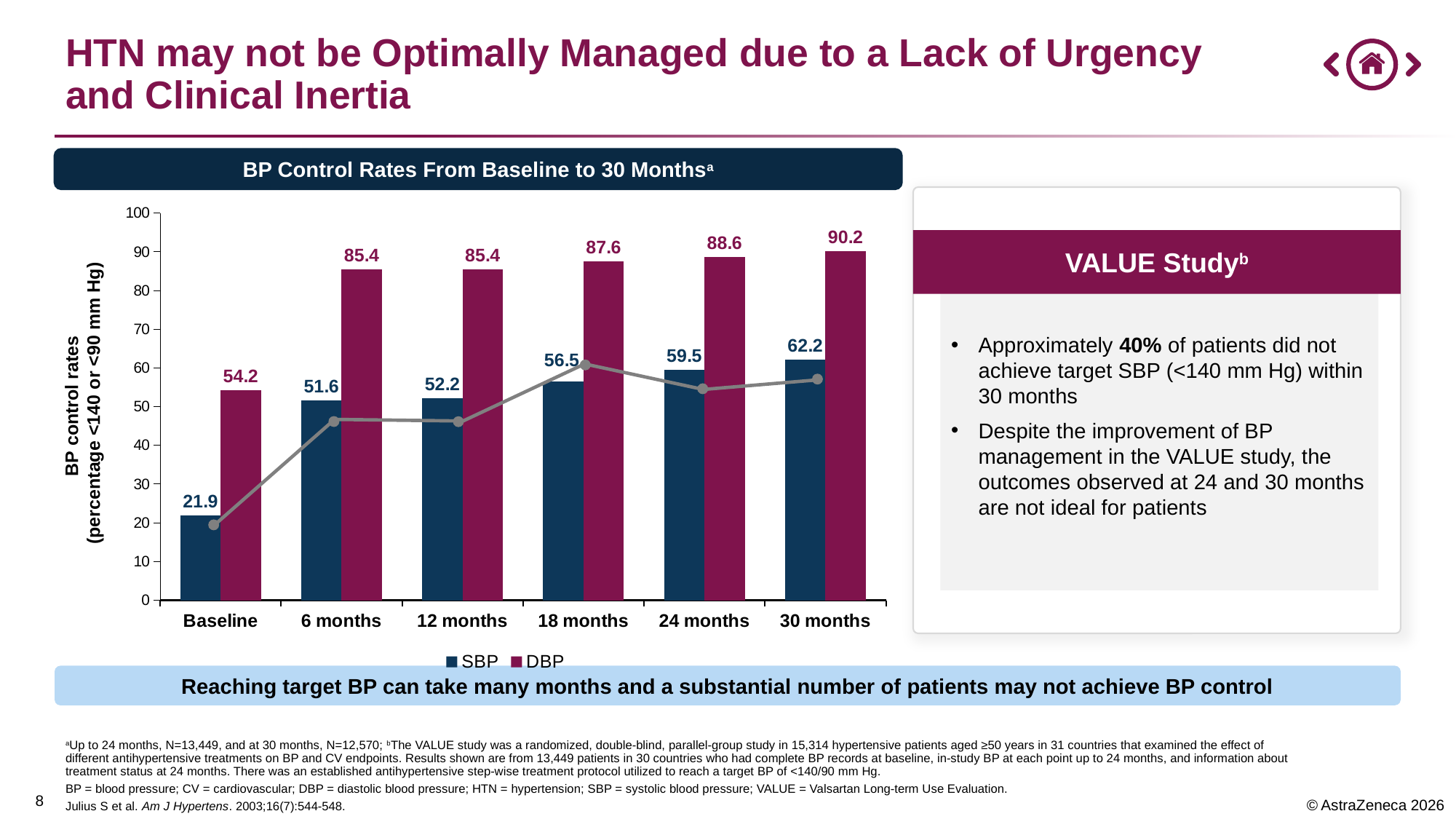
What kind of chart is shown on the slide? Bar chart At which time point is the SBP control rate lowest? Baseline Is the SBP control rate at 30 months greater or less than 60? greater What is the difference between the DBP and SBP control rates at 24 months? 29.1 Does the SBP control rate rise or fall from baseline to 30 months? Rise What is the SBP control rate at baseline? 21.9 What is the SBP control rate at 18 months? 56.5 How many series does the legend list? 2 Which is larger at 6 months, the SBP control rate or the DBP control rate? DBP How many time points are shown on the x axis? 6 At which time point is the DBP control rate highest? 30 months What is the DBP control rate at 30 months? 90.2